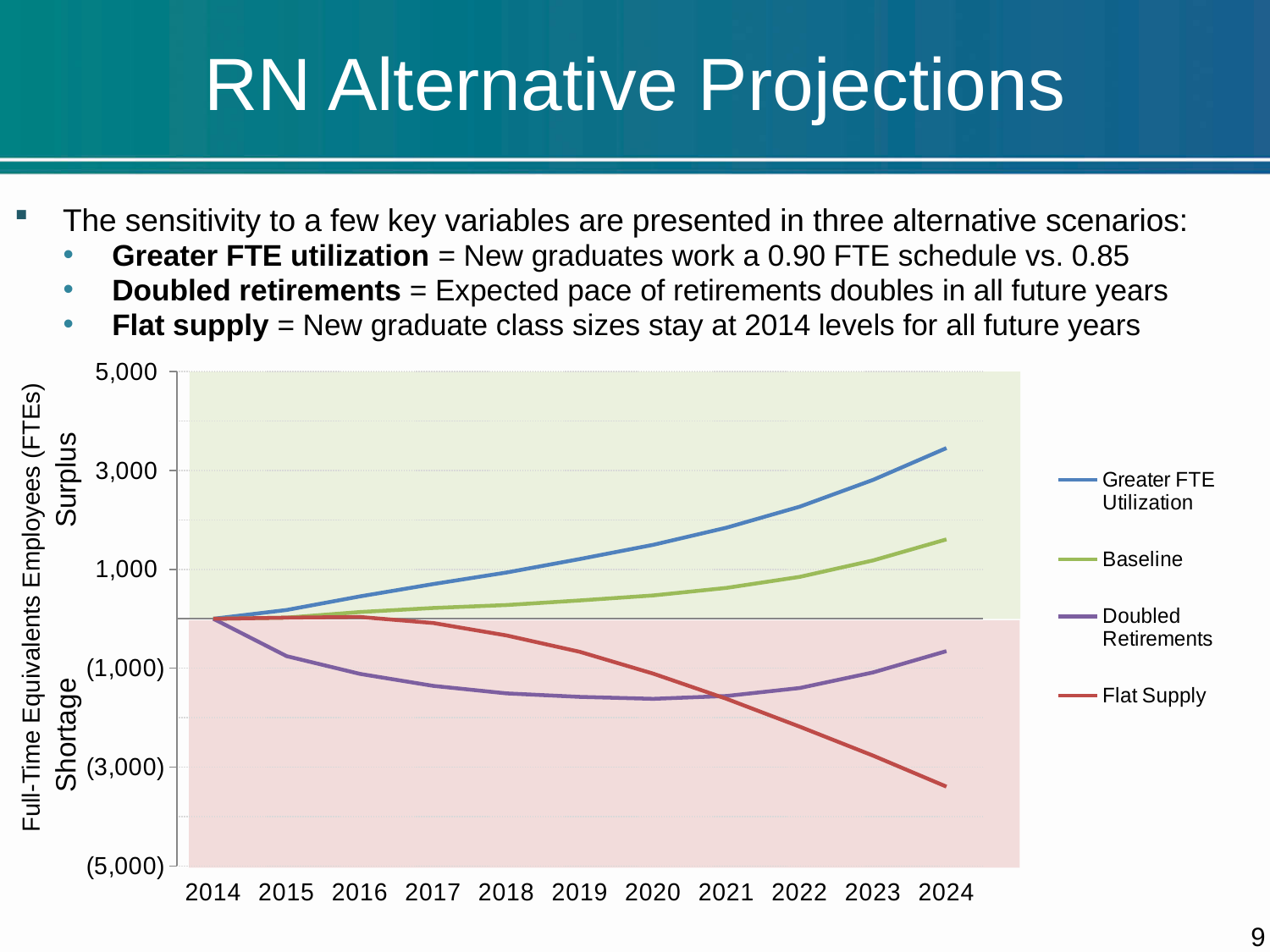
In 2024, which is higher: Doubled Retirements or Flat Supply? Doubled Retirements How many years are shown along the x axis? 11 Does the Greater FTE Utilization line rise or fall from 2014 to 2024? rise Is the value for Greater FTE Utilization in 2024 greater or less than 3,000? greater Which series has the lowest value in 2024? Flat Supply Does the Flat Supply line rise or fall from 2014 to 2024? fall How many series does the legend list? 4 Is the value for Flat Supply in 2024 greater or less than (3,000)? less What is the label on the vertical axis? Full-Time Equivalents Employees (FTEs) Which series has the highest value in 2024? Greater FTE Utilization Is the value for Baseline in 2024 greater or less than 1,000? greater What kind of chart is shown on the slide? line chart